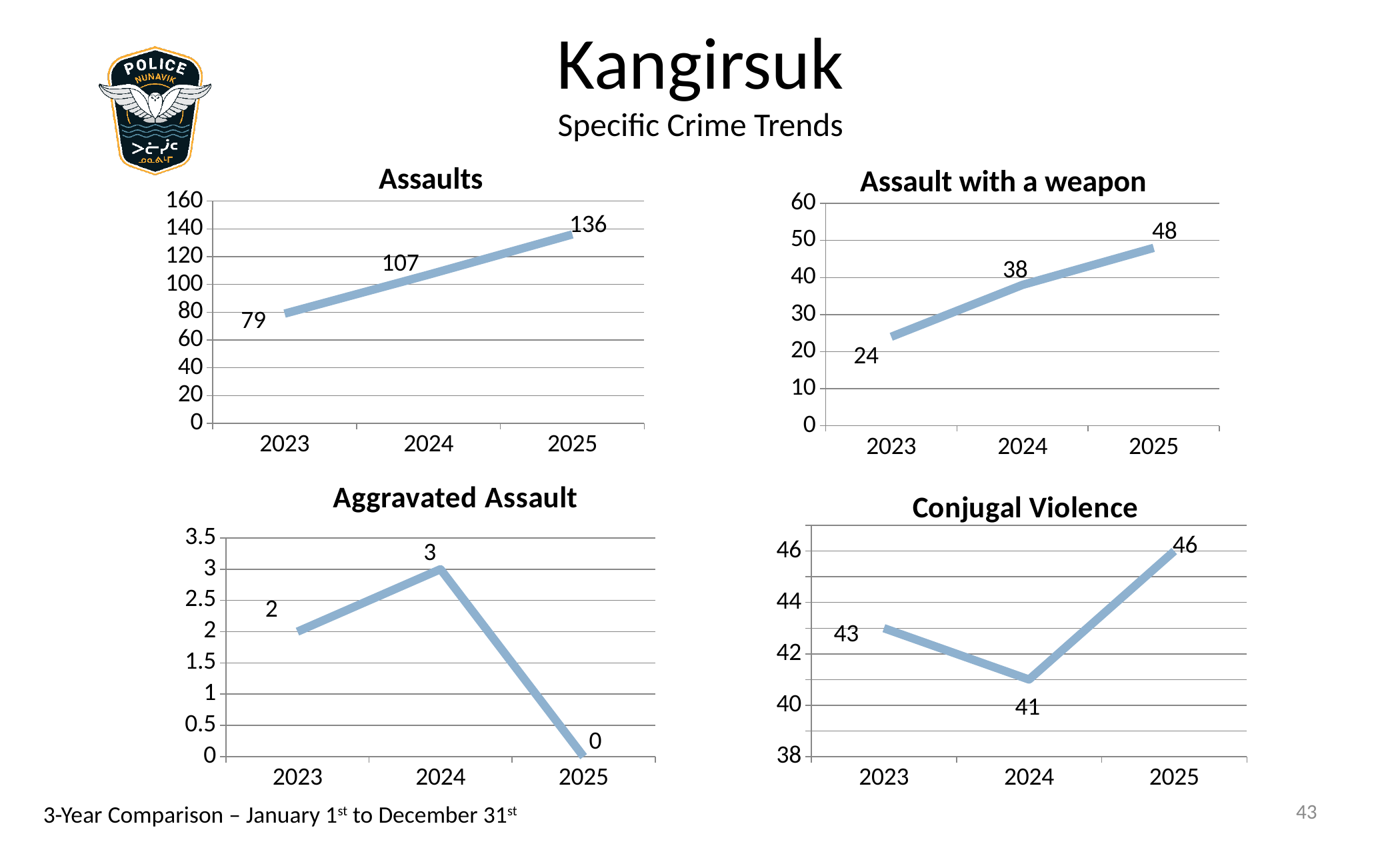
In the Conjugal Violence chart, what is the value for 2024? 41 In the Aggravated Assault chart, which year has the lowest value? 2025 In the Aggravated Assault chart, what is the value for 2024? 3 How many years are plotted in the Assault with a weapon chart? 3 In the Assaults chart, what is the value for 2025? 136 In the Conjugal Violence chart, which is larger, the value for 2023 or the value for 2025? 2025 What kind of chart is the Assaults chart? Line chart In the Conjugal Violence chart, what is the difference between the 2025 and 2024 values? 5 In the Assaults chart, do the values rise or fall from 2023 to 2025? Rise In the Assaults chart, what is the difference between the 2025 and 2023 values? 57 In the Assault with a weapon chart, which year has the highest value? 2025 In the Assault with a weapon chart, what is the value for 2023? 24